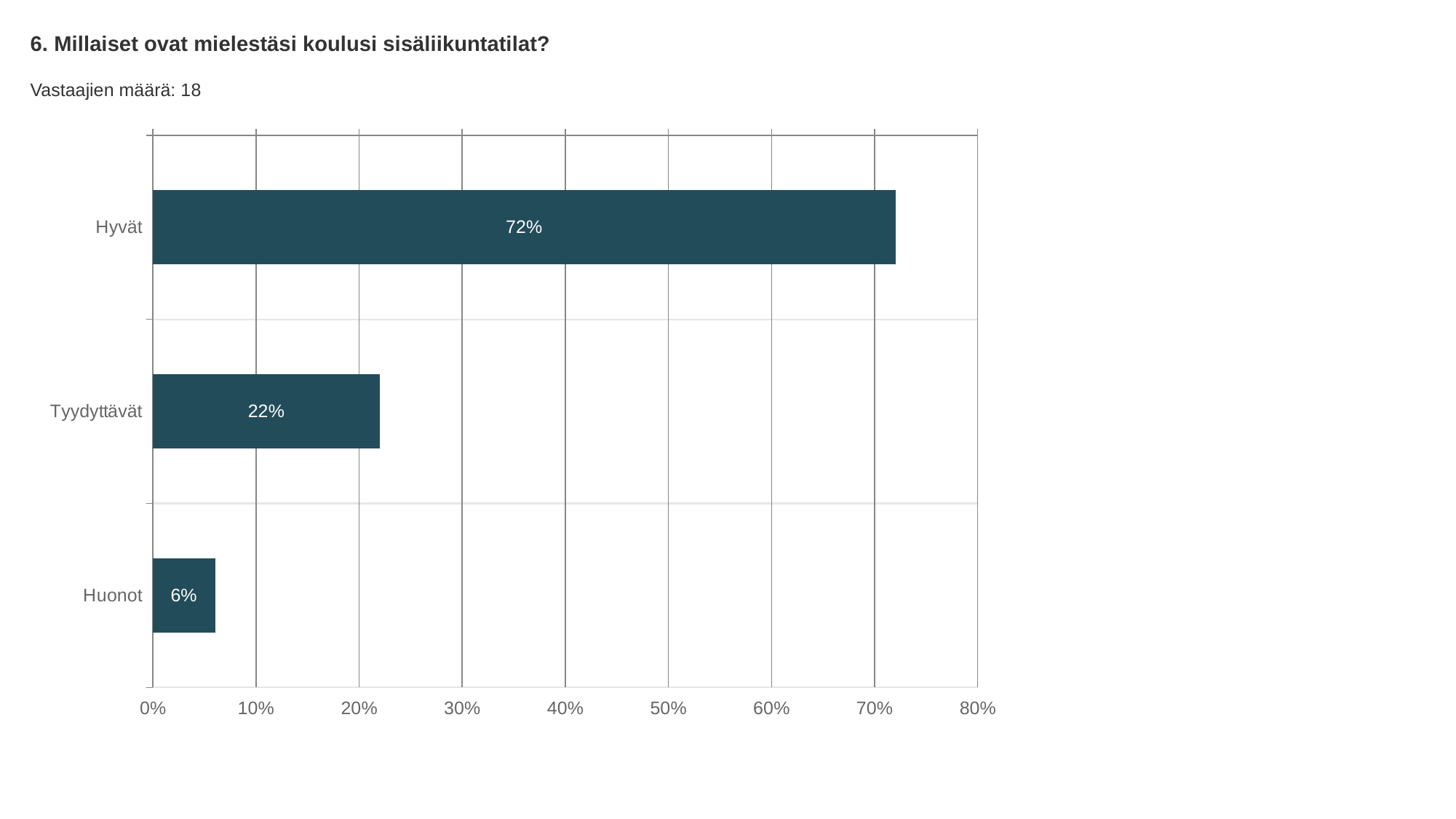
How many categories are shown in the chart? 3 Is the value for "Hyvät" greater or less than 70%? greater How many respondents (Vastaajien määrä) are reported on the slide? 18 Which category has the highest value? Hyvät What is the value shown for "Huonot"? 6% Which is larger, the value for "Tyydyttävät" or the value for "Huonot"? Tyydyttävät What is the difference between the values for "Hyvät" and "Tyydyttävät"? 50% What is the value shown for "Tyydyttävät"? 22% What percentage of respondents answered "Hyvät"? 72% Which category has the lowest value? Huonot What is the difference between the values for "Tyydyttävät" and "Huonot"? 16% What kind of chart is shown on the slide? bar chart